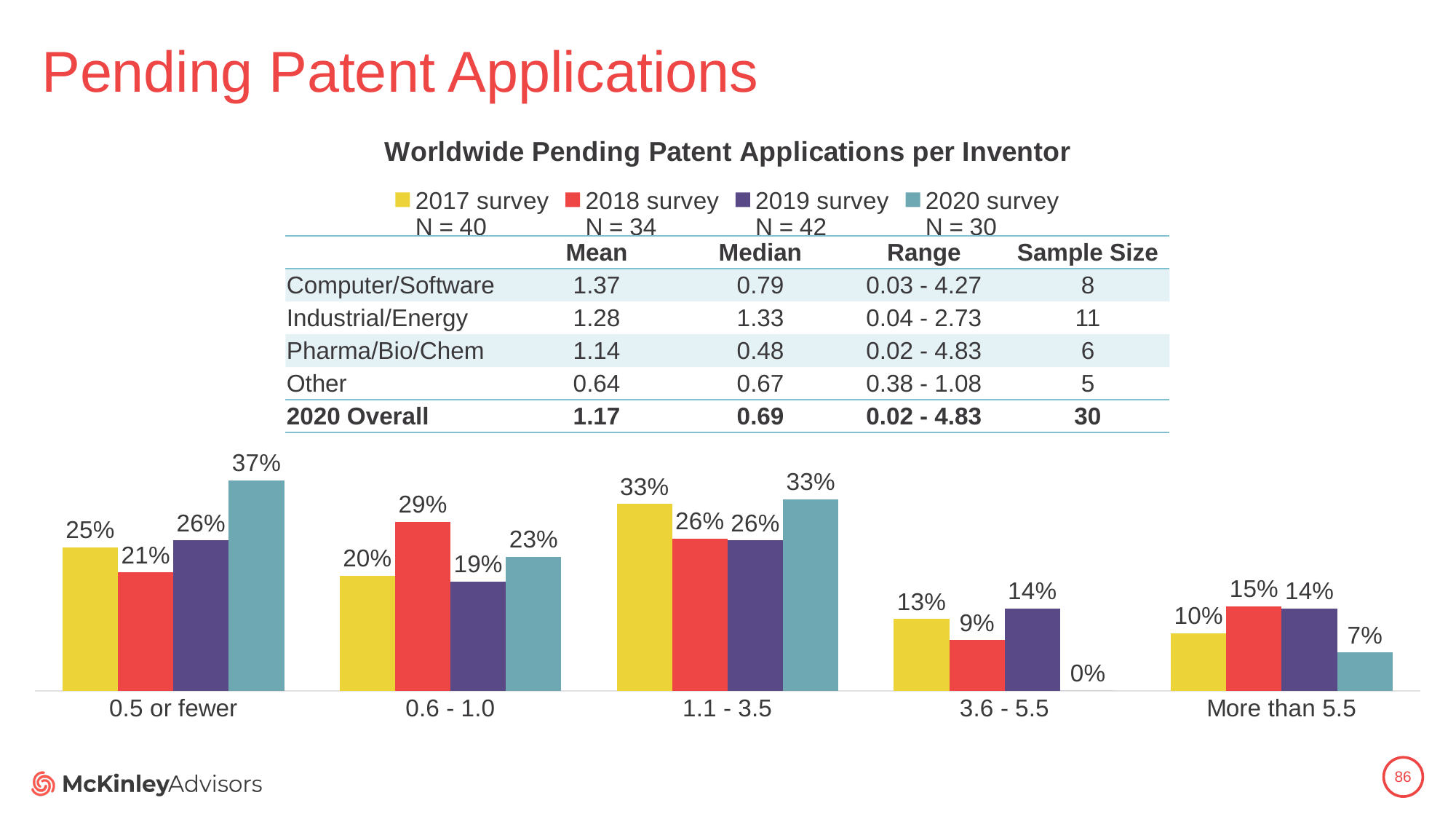
How many series does the chart legend list? 4 What is the value for the 2018 survey in the "0.6 - 1.0" category? 29% What kind of chart is shown on the slide? Bar chart What is the sample size (N) for the 2019 survey shown in the legend? N = 42 Which survey year has the highest value in the "0.5 or fewer" category? 2020 survey Which survey year has the lowest value in the "More than 5.5" category? 2020 survey Which is larger in the "0.6 - 1.0" category: the 2018 survey value or the 2019 survey value? 2018 survey What is the value for the 2017 survey in the "More than 5.5" category? 10% How many categories are shown on the x axis of the chart? 5 What is the value for the 2020 survey in the "0.5 or fewer" category? 37% What is the value for the 2020 survey in the "3.6 - 5.5" category? 0% What is the difference between the 2020 survey and the 2017 survey values in the "0.5 or fewer" category? 12%